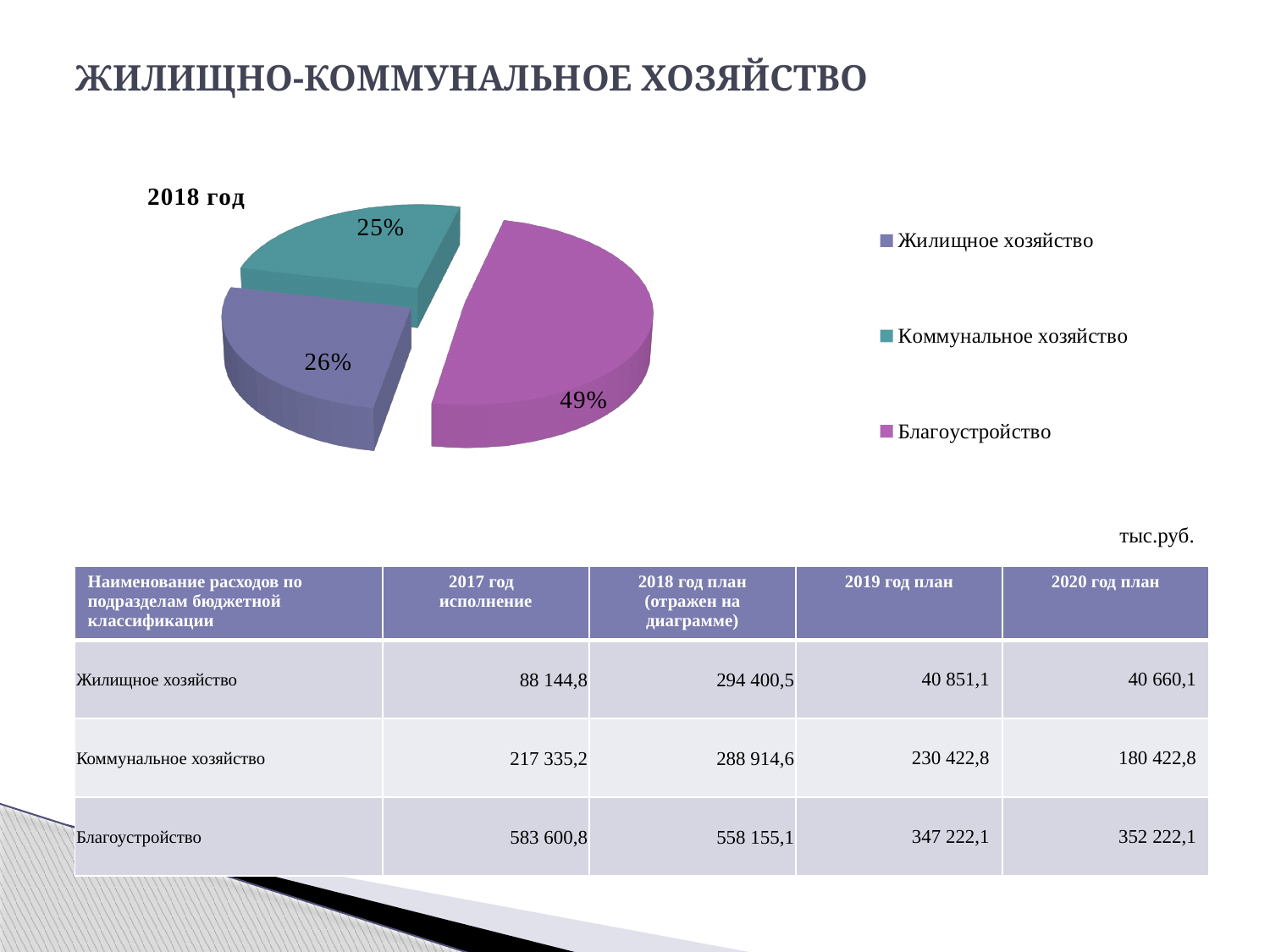
What is the chart's title? 2018 год Which is larger, the Жилищное хозяйство slice or the Коммунальное хозяйство slice? Жилищное хозяйство What share of the pie does Благоустройство have? 49% What is the difference in percentage points between the Благоустройство slice and the Жилищное хозяйство slice? 23 Which category has the smallest slice of the pie? Коммунальное хозяйство Which category has the largest slice of the pie? Благоустройство What share of the pie does Жилищное хозяйство have? 26% What kind of chart is shown on the slide? pie chart Which legend entry is shown in magenta? Благоустройство How many entries does the legend list? 3 What share of the pie does Коммунальное хозяйство have? 25% How many slices does the pie chart have? 3